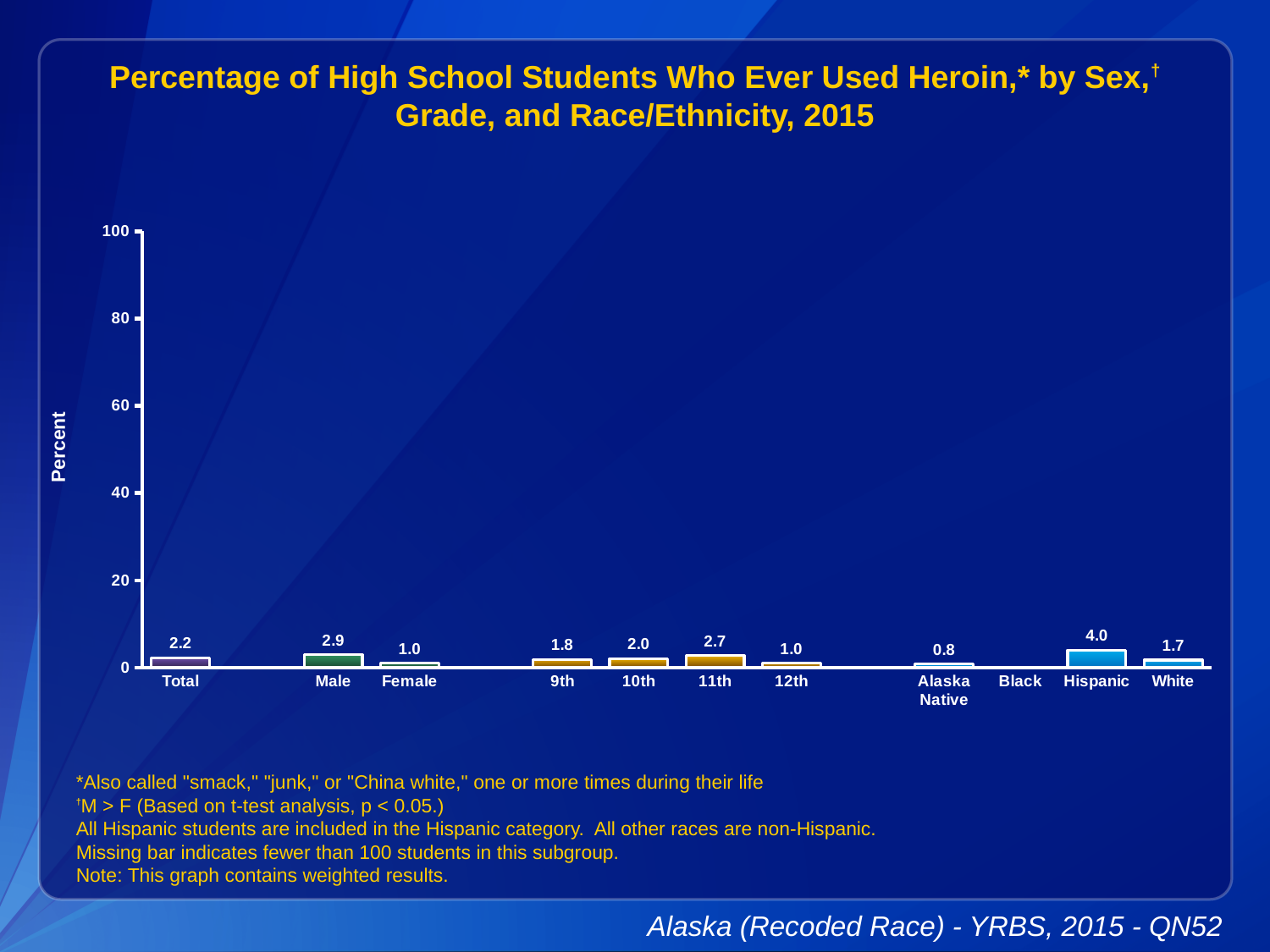
What is the value for Male? 2.9 Which category has no bar shown? Black What is the value for Total? 2.2 Is the value for Hispanic greater or less than 20? less Which is larger, the value for 10th grade or the value for 12th grade? 10th Which category has the highest value? Hispanic What kind of chart is shown? bar chart What is the value for 11th grade? 2.7 Which category has the lowest value among those with a bar shown? Alaska Native What is the difference between the Male and Female values? 1.9 What is the label on the y axis? Percent What is the value for Hispanic? 4.0